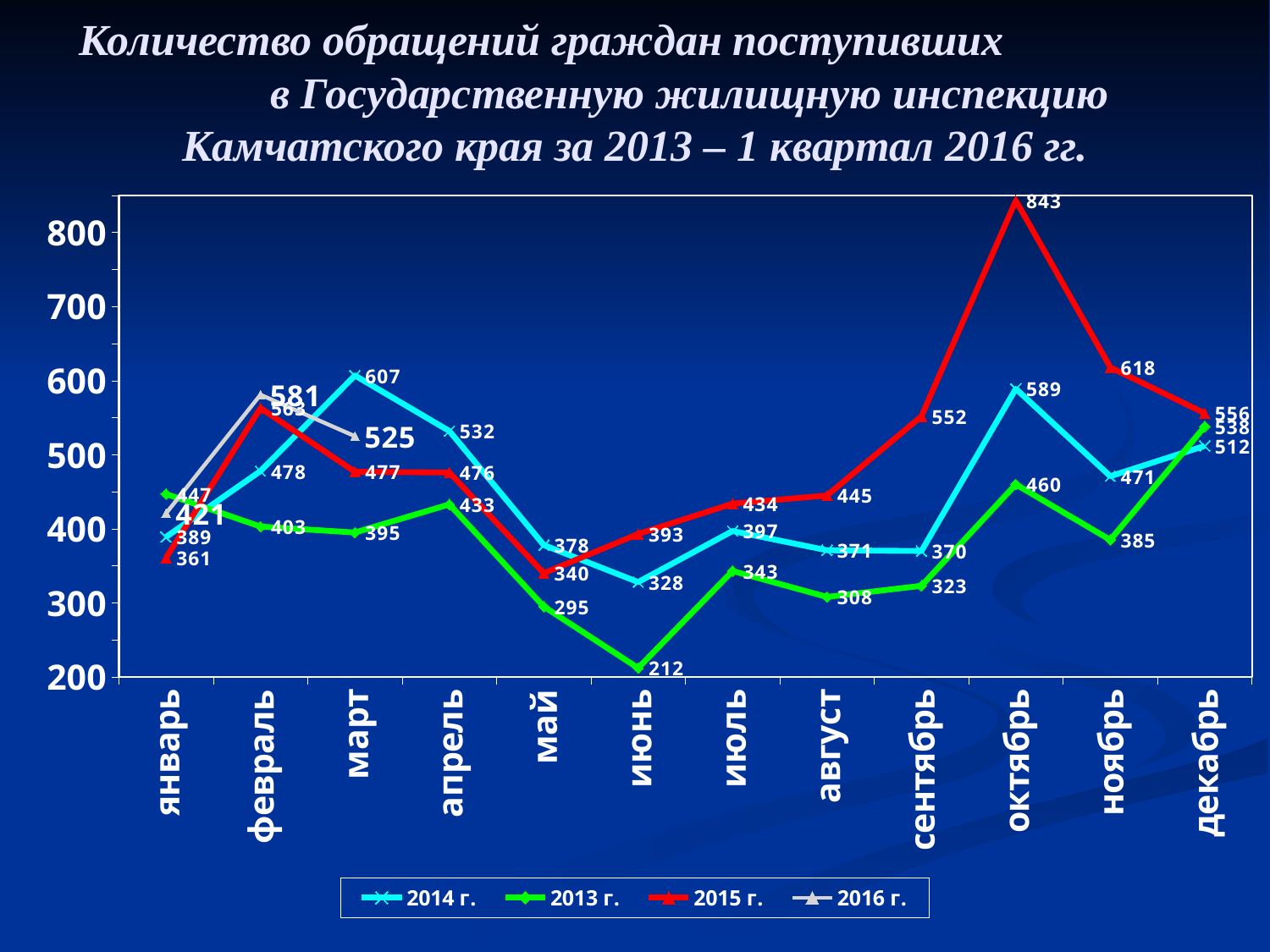
Does the 2013 г. series rise or fall from январь to март? fall In which month does the 2015 г. series reach its highest value? октябрь What is the value for 2016 г. in февраль? 581 How many series does the legend list? 4 What is the difference between the 2014 г. and 2013 г. values in март? 212 What is the value for 2014 г. in март? 607 Which series has the larger value in июнь, 2015 г. or 2014 г.? 2015 г. What is the value for 2015 г. in октябрь? 843 What kind of chart is shown on the slide? line chart How many months are shown along the x axis? 12 Is the value for 2015 г. in ноябрь greater or less than 600? greater In which month does the 2013 г. series reach its lowest value? июнь